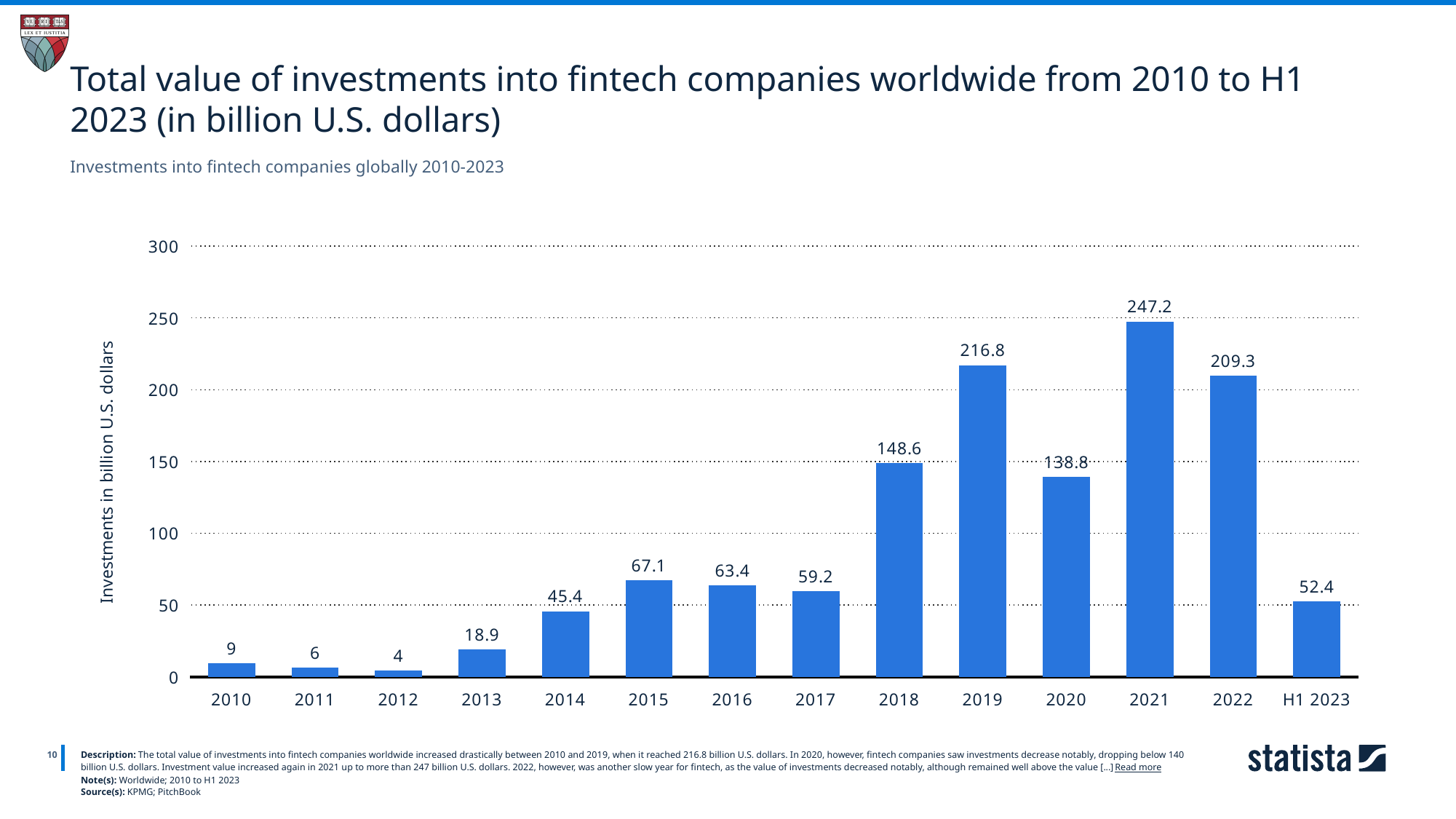
What value is shown for 2014? 45.4 What value is shown for H1 2023? 52.4 What was the total value of investments into fintech companies worldwide in 2019? 216.8 What is the label of the y axis? Investments in billion U.S. dollars Which year has the highest value of fintech investments? 2021 Is the value for 2020 greater or less than 150? less How many time periods are shown on the x axis? 14 Which year has the lowest value of fintech investments? 2012 Which is larger, the value for 2016 or the value for 2017? 2016 What is the difference between the values for 2021 and 2022? 37.9 What is the difference between the values for 2018 and 2020? 9.8 What kind of chart is shown on the slide? bar chart